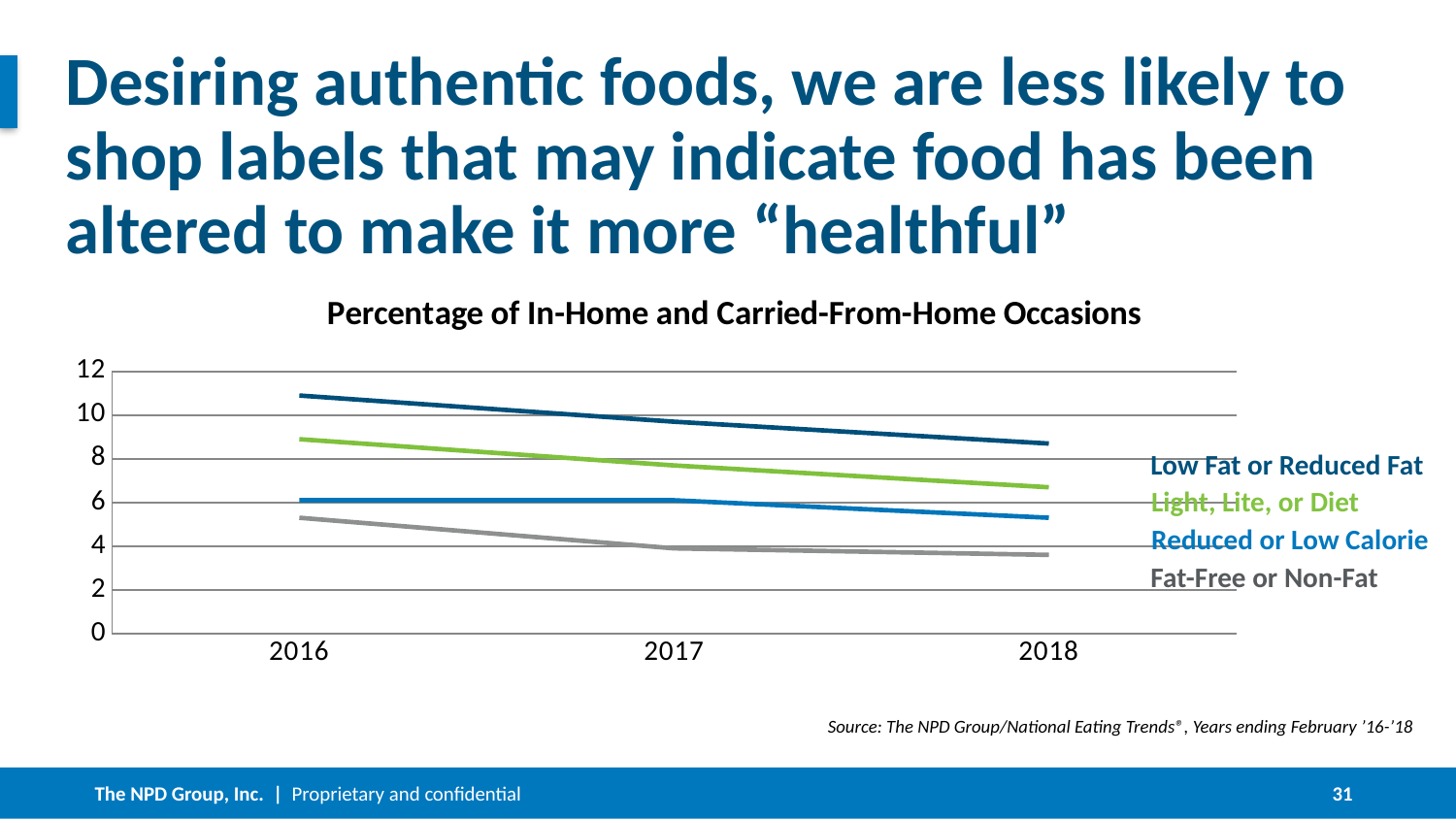
Is the value for Light, Lite, or Diet in 2018 greater or less than 8? less Does the value for Low Fat or Reduced Fat rise or fall from 2016 to 2018? fall Does the value for Fat-Free or Non-Fat rise or fall from 2016 to 2018? fall Which series has the lowest value in 2018? Fat-Free or Non-Fat How many years are shown on the x axis of the chart? 3 What is the title of the chart? Percentage of In-Home and Carried-From-Home Occasions What kind of chart is shown on the slide? line chart How many series does the chart's legend list? 4 Is the value for Low Fat or Reduced Fat in 2016 greater or less than 10? greater Which series has the highest value in 2018? Low Fat or Reduced Fat Is the value for Fat-Free or Non-Fat in 2016 greater or less than 4? greater In 2016, which is larger: Light, Lite, or Diet or Reduced or Low Calorie? Light, Lite, or Diet